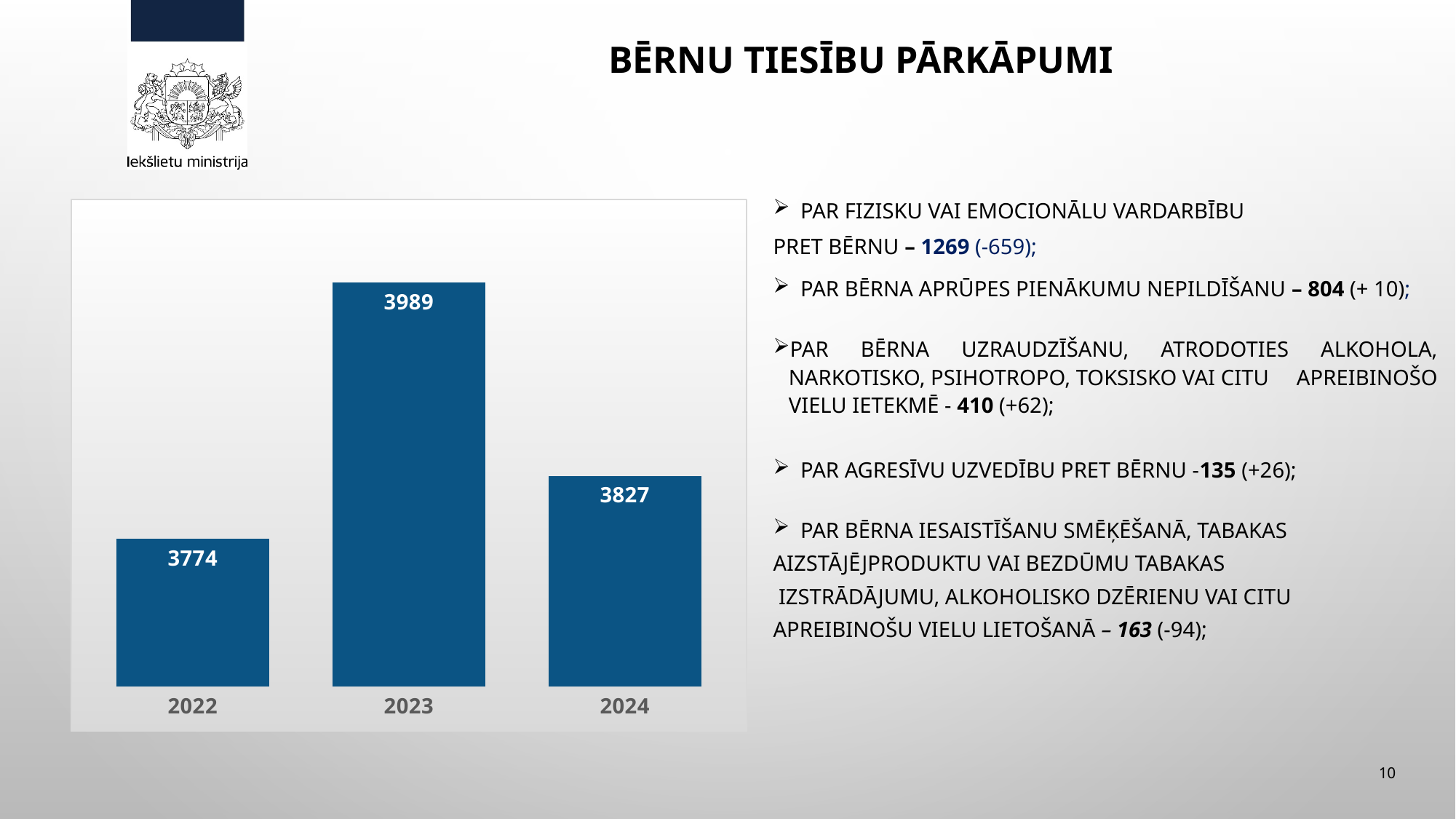
What kind of chart is shown on the slide? bar chart What is the difference between the values for 2023 and 2024? 162 What is the value shown for 2022? 3774 What is the value shown for 2023? 3989 What is the title of the slide containing the chart? BĒRNU TIESĪBU PĀRKĀPUMI What is the value shown for 2024? 3827 Which year has the highest value? 2023 Which is larger, the value for 2022 or the value for 2024? 2024 How many years are shown on the chart? 3 Which year has the lowest value? 2022 Does the value rise or fall from 2023 to 2024? fall What is the difference between the values for 2023 and 2022? 215